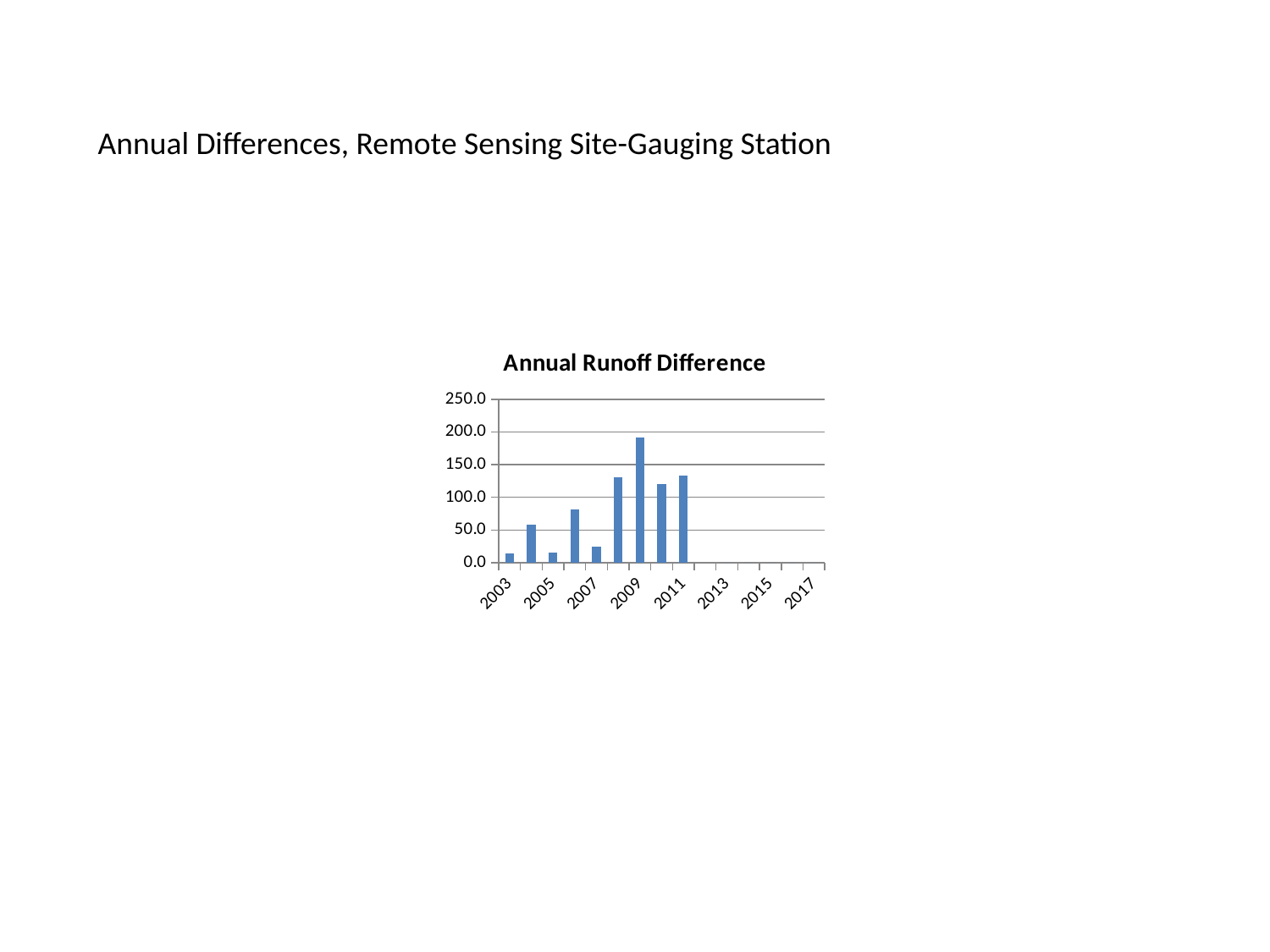
How many bars are plotted in the chart? 9 Which year has the highest Annual Runoff Difference? 2009 Which is larger, the value for 2006 or the value for 2004? 2006 What is the highest value shown on the vertical axis? 250.0 Is the value for 2007 greater or less than 50? less Is the value for 2008 greater or less than 100? greater Is the value for 2006 greater or less than 100? less What kind of chart is shown on the slide? bar chart What is the title of the chart? Annual Runoff Difference Which is larger, the value for 2009 or the value for 2008? 2009